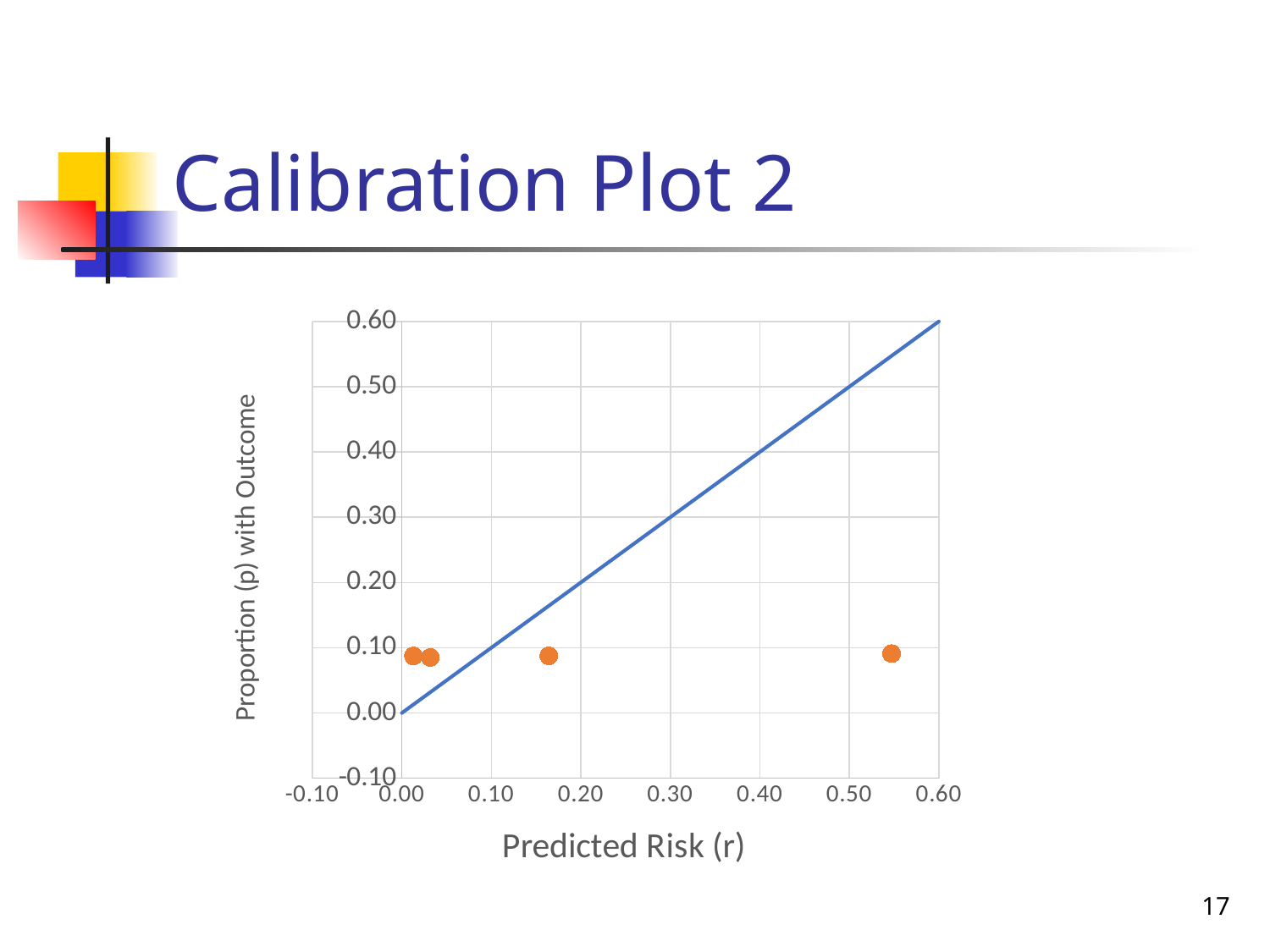
What is the value of the diagonal line at a Predicted Risk of 0.60? 0.60 What is the label of the y axis? Proportion (p) with Outcome What is the label of the x axis? Predicted Risk (r) How many orange data points are plotted on the chart? 4 Is the Predicted Risk of the third data point from the left greater or less than 0.10? greater What kind of chart is shown on the slide? Scatter plot What is the value of the diagonal line at a Predicted Risk of 0.00? 0.00 Do the orange data points rise, fall, or stay roughly flat as Predicted Risk increases? Stay roughly flat Is the Proportion with Outcome for the data point near Predicted Risk 0.17 greater or less than 0.20? less Is the Proportion with Outcome for the rightmost data point greater or less than 0.20? less What is the highest value shown on the y axis? 0.60